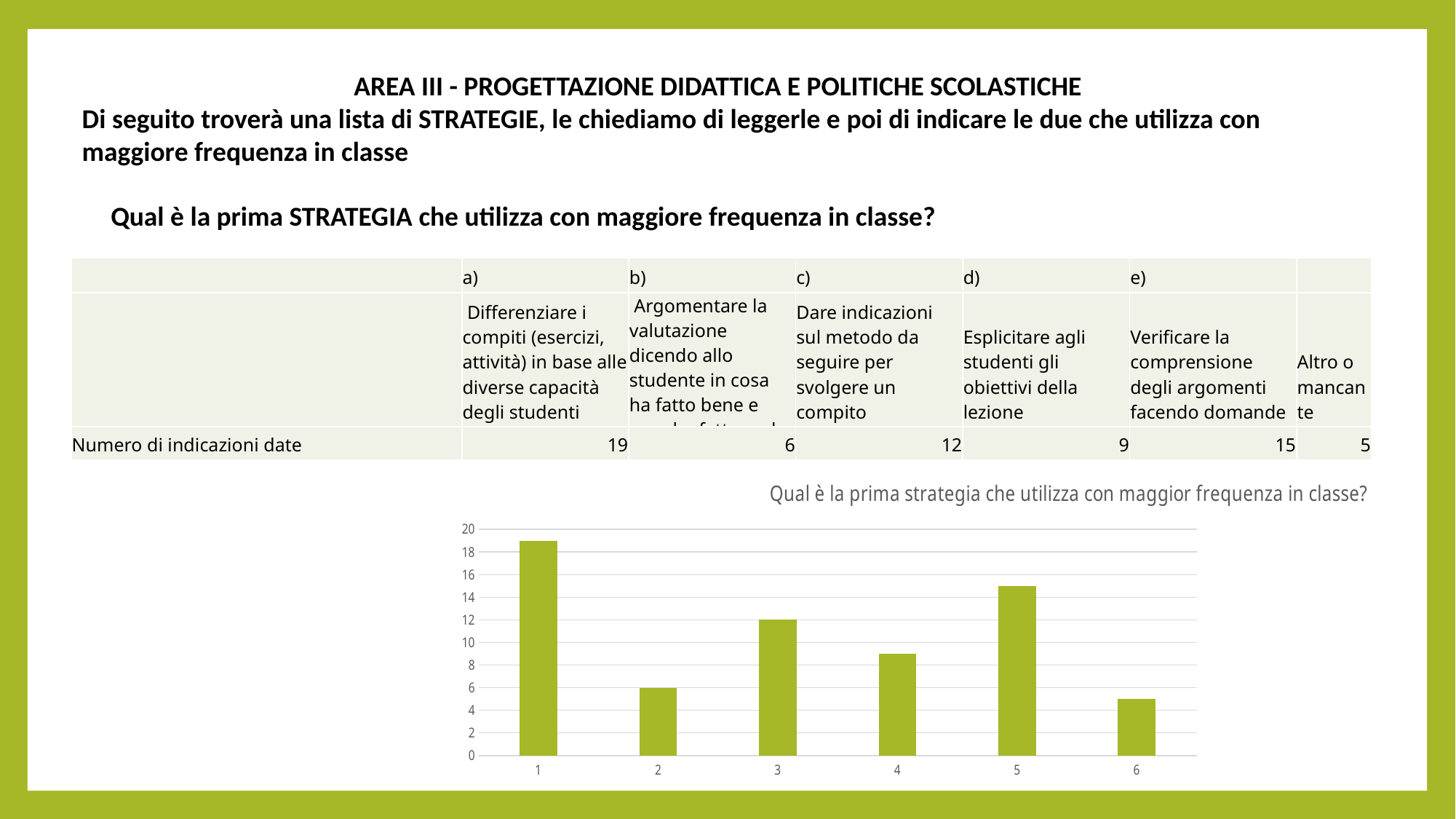
What is the value of the bar for category 5? 15 What type of chart is shown on the slide? bar chart How many bars are plotted in the chart? 6 What is the difference between the values for category 1 and category 5? 4 What is the value of the bar for category 3? 12 What is the maximum value shown on the vertical axis? 20 Which category has the highest bar? 1 What is the title of the chart? Qual è la prima strategia che utilizza con maggior frequenza in classe? What is the value of the bar for category 1? 19 Is the value for category 4 greater or less than 10? less Which is larger, the bar for category 2 or the bar for category 4? category 4 Which category has the lowest bar? 6